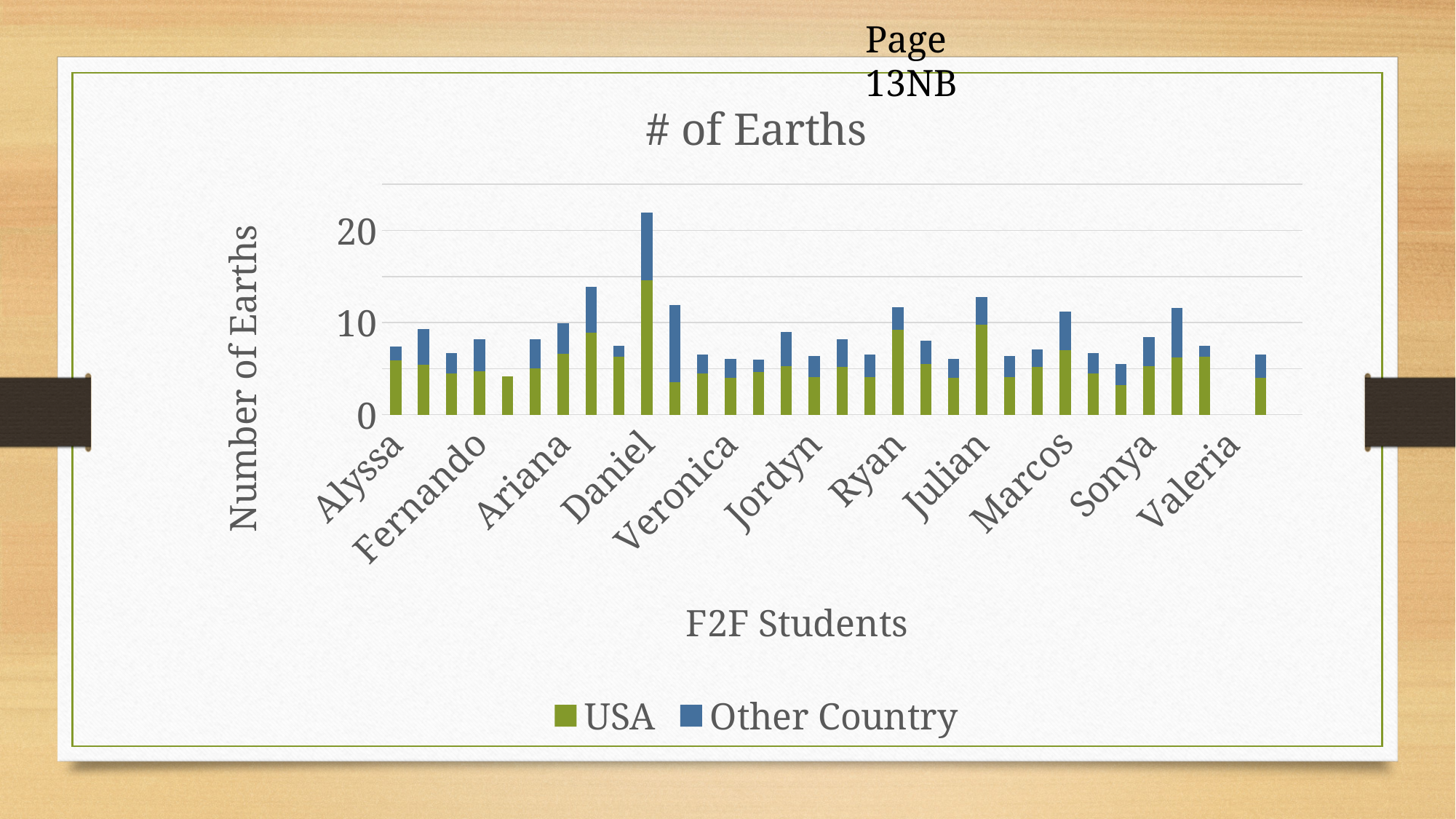
Which has the larger total number of Earths, Daniel or Alyssa? Daniel Is the total value for Ryan greater or less than 10? greater Is the total value for Daniel greater or less than 20? greater Is the total value for Alyssa greater or less than 10? less How many series does the legend list? 2 Which student has the highest total number of Earths? Daniel What is the title of the chart? # of Earths Which has the larger total number of Earths, Julian or Jordyn? Julian What is the label on the vertical axis? Number of Earths What kind of chart is shown on the slide? Stacked bar chart